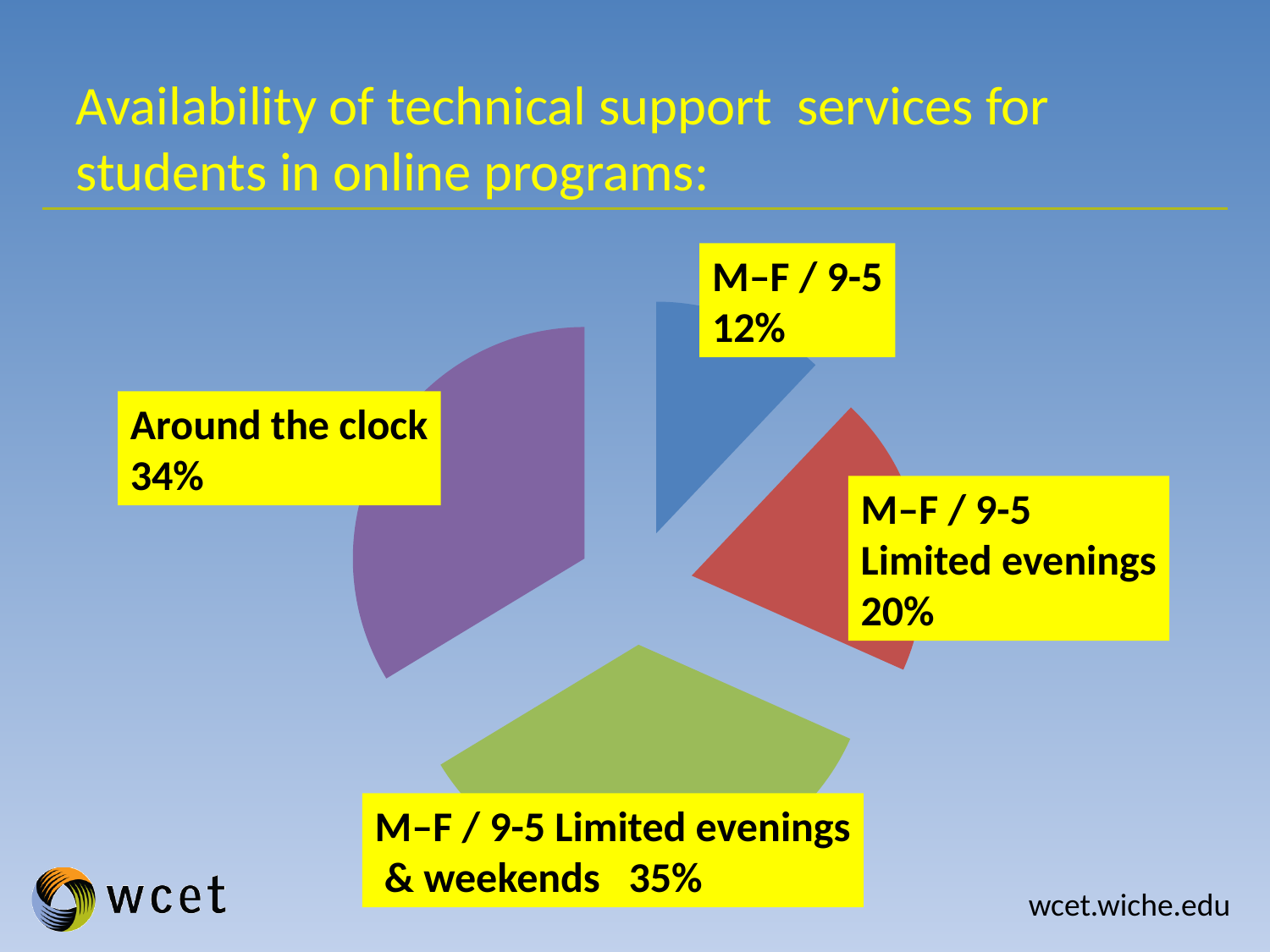
What is the value shown for "M–F / 9-5 Limited evenings"? 20% Which category has the largest slice of the pie? M–F / 9-5 Limited evenings & weekends How many percentage points larger is "Around the clock" than "M–F / 9-5"? 22 What percentage is shown for "M–F / 9-5 Limited evenings & weekends"? 35% What share does the "Around the clock" slice represent? 34% Which is larger: the share for "Around the clock" or for "M–F / 9-5 Limited evenings"? Around the clock What is the difference in percentage points between "M–F / 9-5 Limited evenings & weekends" and "M–F / 9-5 Limited evenings"? 15 How many slices does the pie chart have? 4 What percentage of the pie is labelled "M–F / 9-5"? 12% What colour is the "Around the clock" slice? Purple What kind of chart is shown on the slide? Pie chart Which category has the smallest slice of the pie? M–F / 9-5